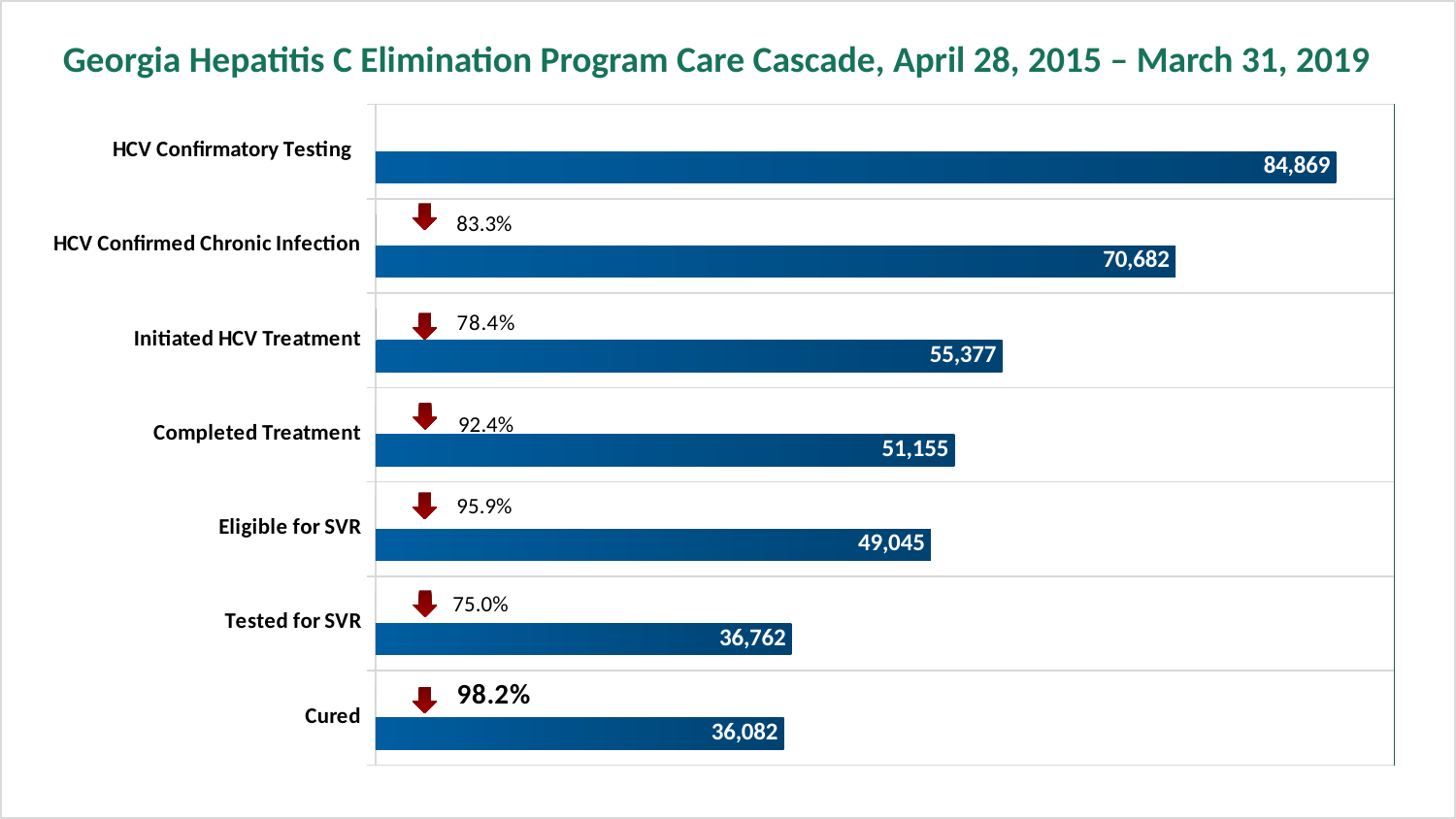
Which category has the highest value? HCV Confirmatory Testing Which category has the lowest value? Cured What kind of chart is this? Bar chart What is the difference between HCV Confirmatory Testing and HCV Confirmed Chronic Infection? 14,187 What is the value for Cured? 36,082 What is the value for HCV Confirmatory Testing? 84,869 Which is larger, Initiated HCV Treatment or Completed Treatment? Initiated HCV Treatment What is the difference between Completed Treatment and Eligible for SVR? 2,110 What is the value for Initiated HCV Treatment? 55,377 How many categories are shown in the chart? 7 What percentage is shown next to the arrow above the Cured bar? 98.2% What is the value for Tested for SVR? 36,762